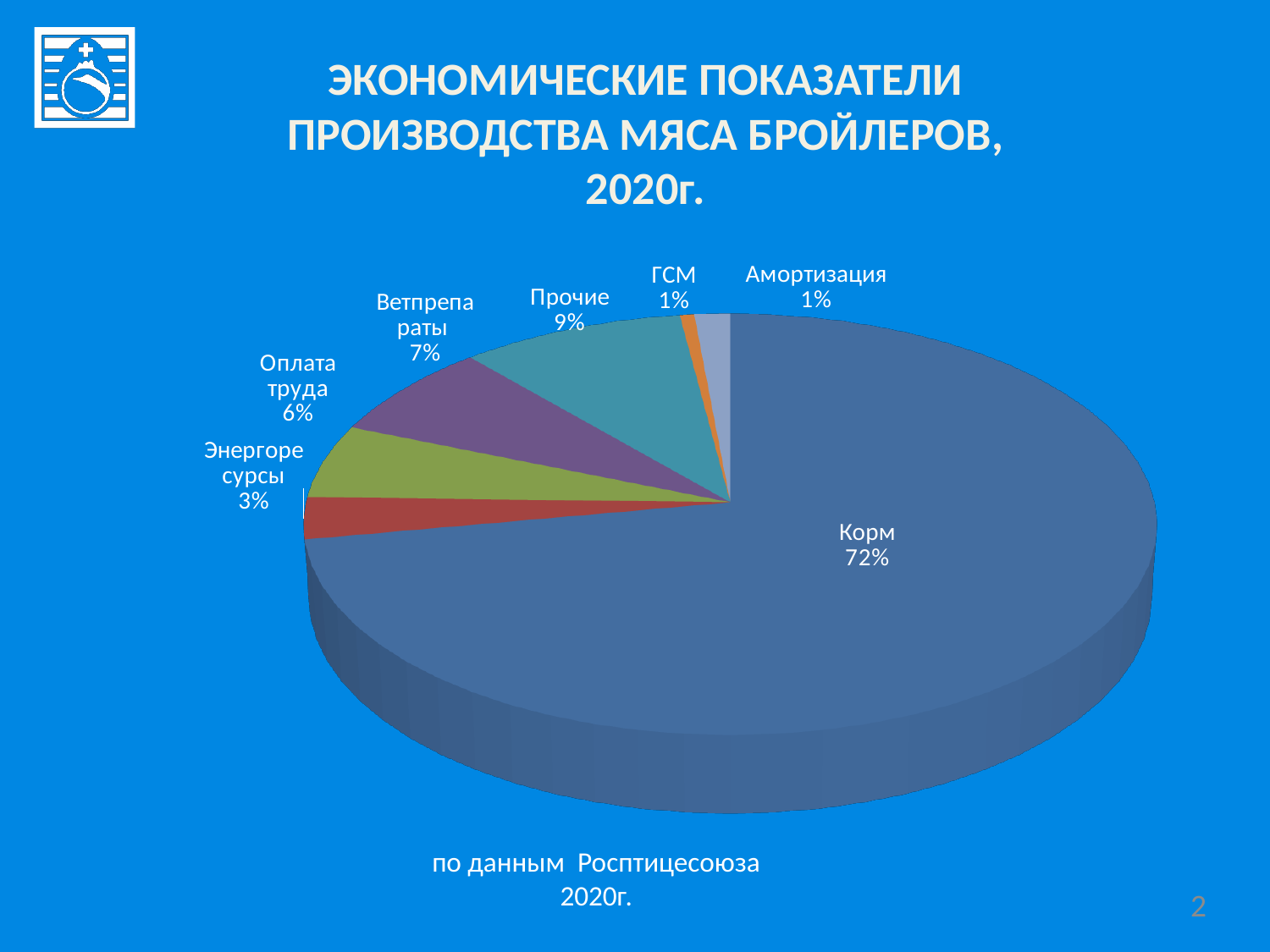
What is the value for Энергоресурсы? 3% What is the difference between the shares of Корм and Прочие? 63% What share of the pie does Корм account for? 72% How many slices does the pie chart have? 7 What percentage is shown for ГСМ? 1% What is the value for Ветпрепараты? 7% What type of chart is shown on the slide? Pie chart What percentage is shown for Прочие? 9% What percentage is shown for Оплата труда? 6% What is the title of the chart on the slide? ЭКОНОМИЧЕСКИЕ ПОКАЗАТЕЛИ ПРОИЗВОДСТВА МЯСА БРОЙЛЕРОВ, 2020г. Which category has the largest slice of the pie? Корм Which is larger, the share of Ветпрепараты or the share of Оплата труда? Ветпрепараты